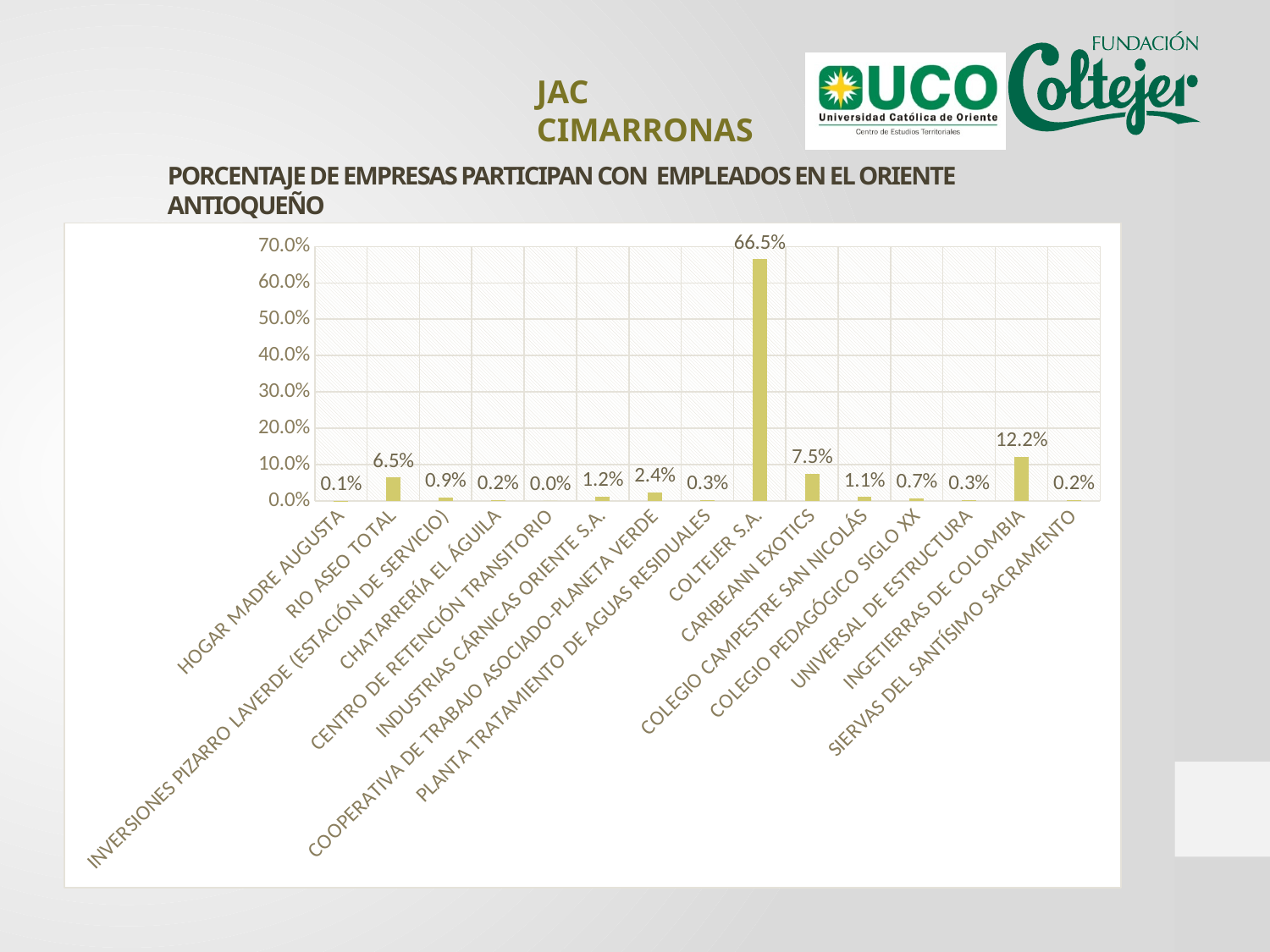
Which company has the highest value? COLTEJER S.A. What kind of chart is this? Bar chart How many companies are shown on the x axis? 15 Which company has the lowest value? CENTRO DE RETENCIÓN TRANSITORIO What is the value for INGETIERRAS DE COLOMBIA? 12.2% What is the value for COLTEJER S.A.? 66.5% Which is larger, the value for CARIBEANN EXOTICS or the value for RIO ASEO TOTAL? CARIBEANN EXOTICS What is the value for COOPERATIVA DE TRABAJO ASOCIADO-PLANETA VERDE? 2.4% What is the difference between the values for COLTEJER S.A. and INGETIERRAS DE COLOMBIA? 54.3% Is the value for COLTEJER S.A. greater or less than 60.0%? greater What is the value for CARIBEANN EXOTICS? 7.5% What is the value for RIO ASEO TOTAL? 6.5%